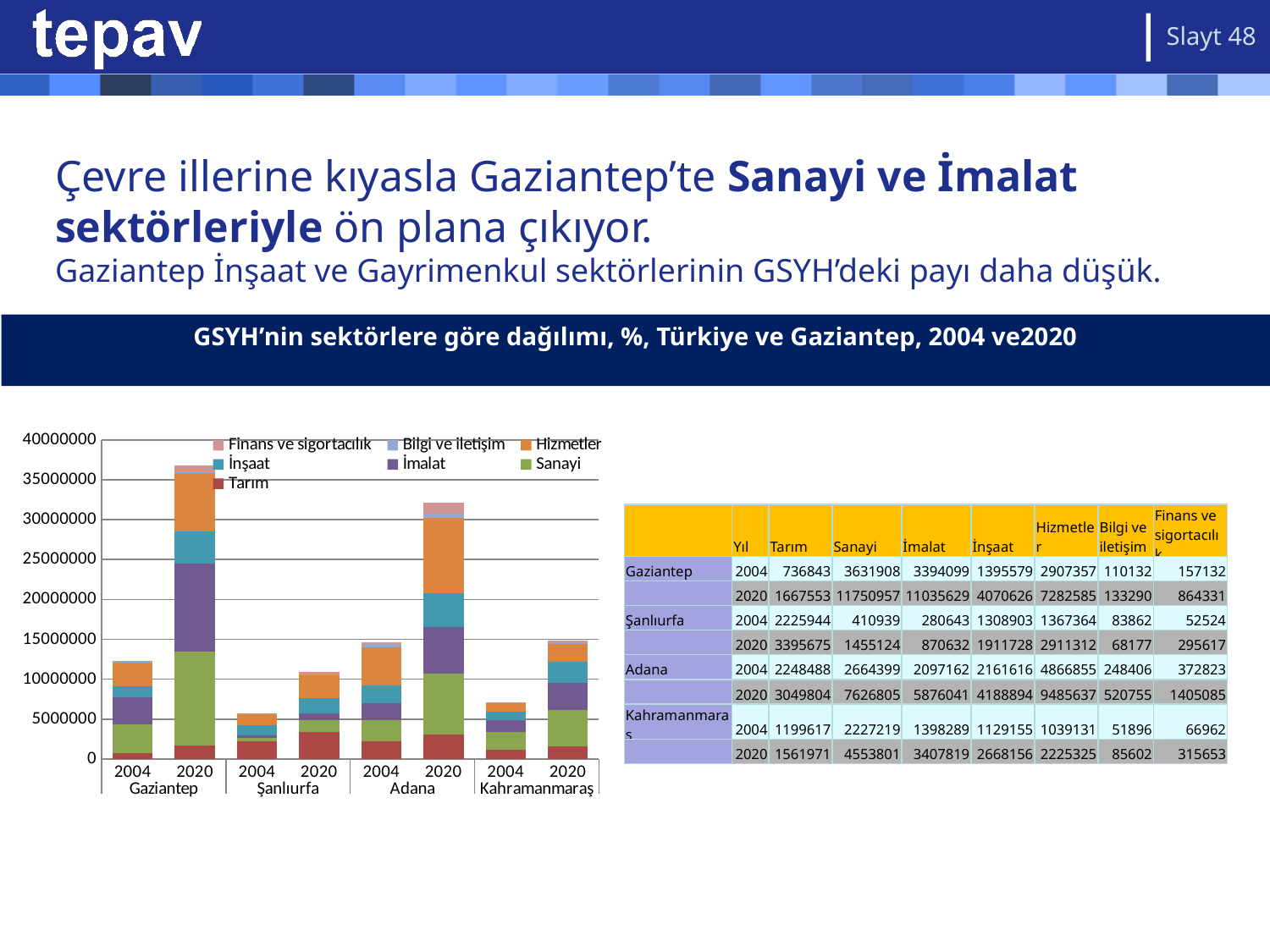
Is the total for Adana 2020 greater or less than 30000000? greater Is the total for Kahramanmaraş 2020 greater or less than 20000000? less How many bars are plotted in the chart? 8 Using the table values, what is the difference between Gaziantep's İmalat value in 2020 and in 2004? 7641530 Is the total for Gaziantep 2020 greater or less than 35000000? greater Which is larger, the total bar for Gaziantep 2020 or for Adana 2020? Gaziantep 2020 Which bar in the chart is the tallest? Gaziantep 2020 How many series does the chart legend list? 7 According to the table on the slide, what is the Hizmetler value for Adana in 2020? 9485637 Which bar in the chart is the shortest? Şanlıurfa 2004 What kind of chart is shown on the slide? Stacked bar chart According to the table on the slide, what is the Sanayi value for Gaziantep in 2020? 11750957